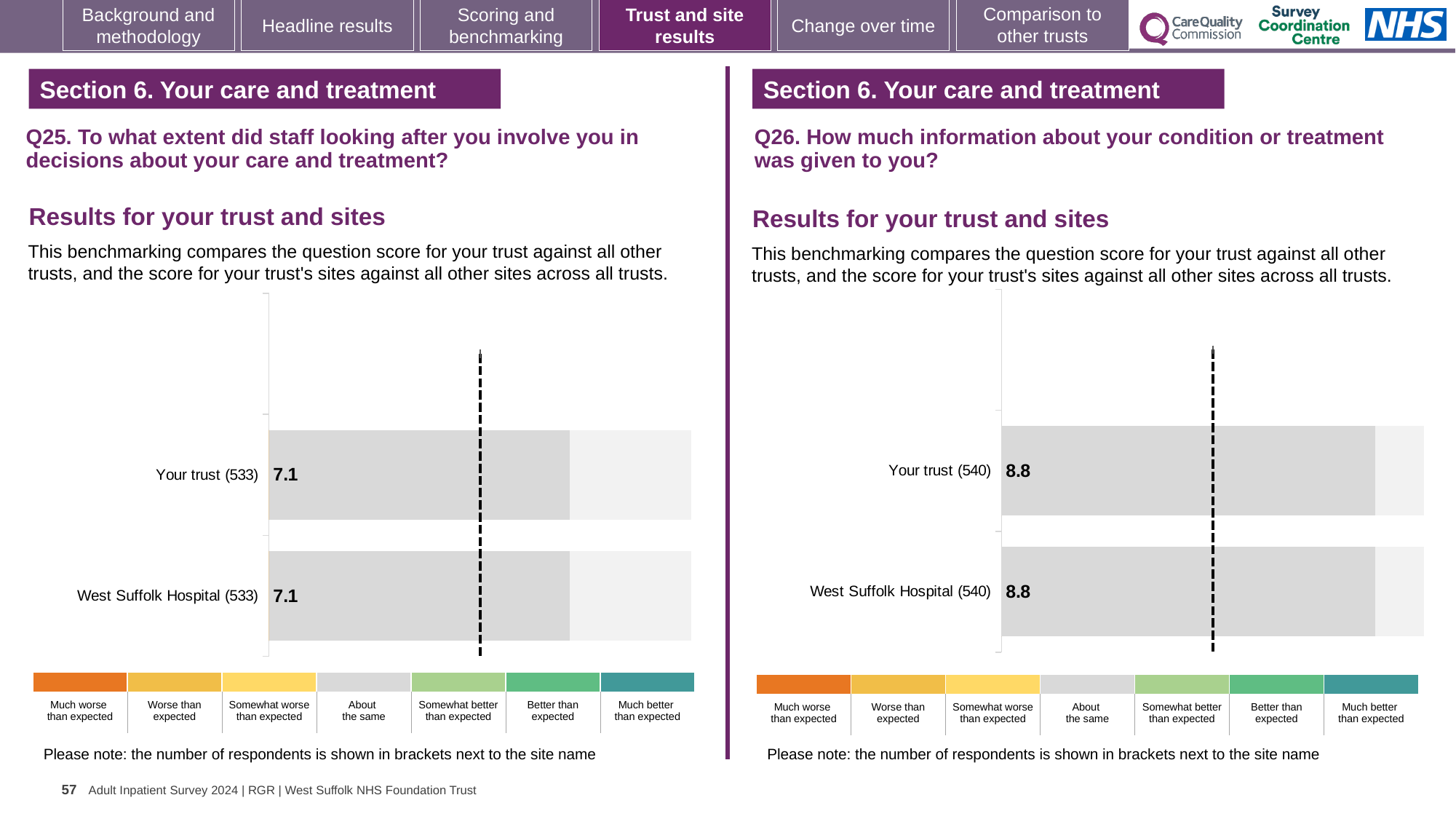
In the Q26 chart on the right, what is the score for West Suffolk Hospital? 8.8 How many bars are plotted in the Q26 chart on the right? 2 In the Q26 chart on the right, what is the difference between the score for Your trust and the score for West Suffolk Hospital? 0.0 What kind of chart is used for the Q25 results on the left? Bar chart How many bars are plotted in the Q25 chart on the left? 2 In the Q26 chart on the right, how many respondents are shown in brackets for West Suffolk Hospital? 540 In the Q26 chart on the right, what is the score for Your trust? 8.8 In the Q25 chart on the left, what is the difference between the score for Your trust and the score for West Suffolk Hospital? 0.0 In the Q25 chart on the left, what is the score for West Suffolk Hospital? 7.1 In the Q25 chart on the left, what is the score for Your trust? 7.1 In the Q25 chart on the left, how many respondents are shown in brackets for Your trust? 533